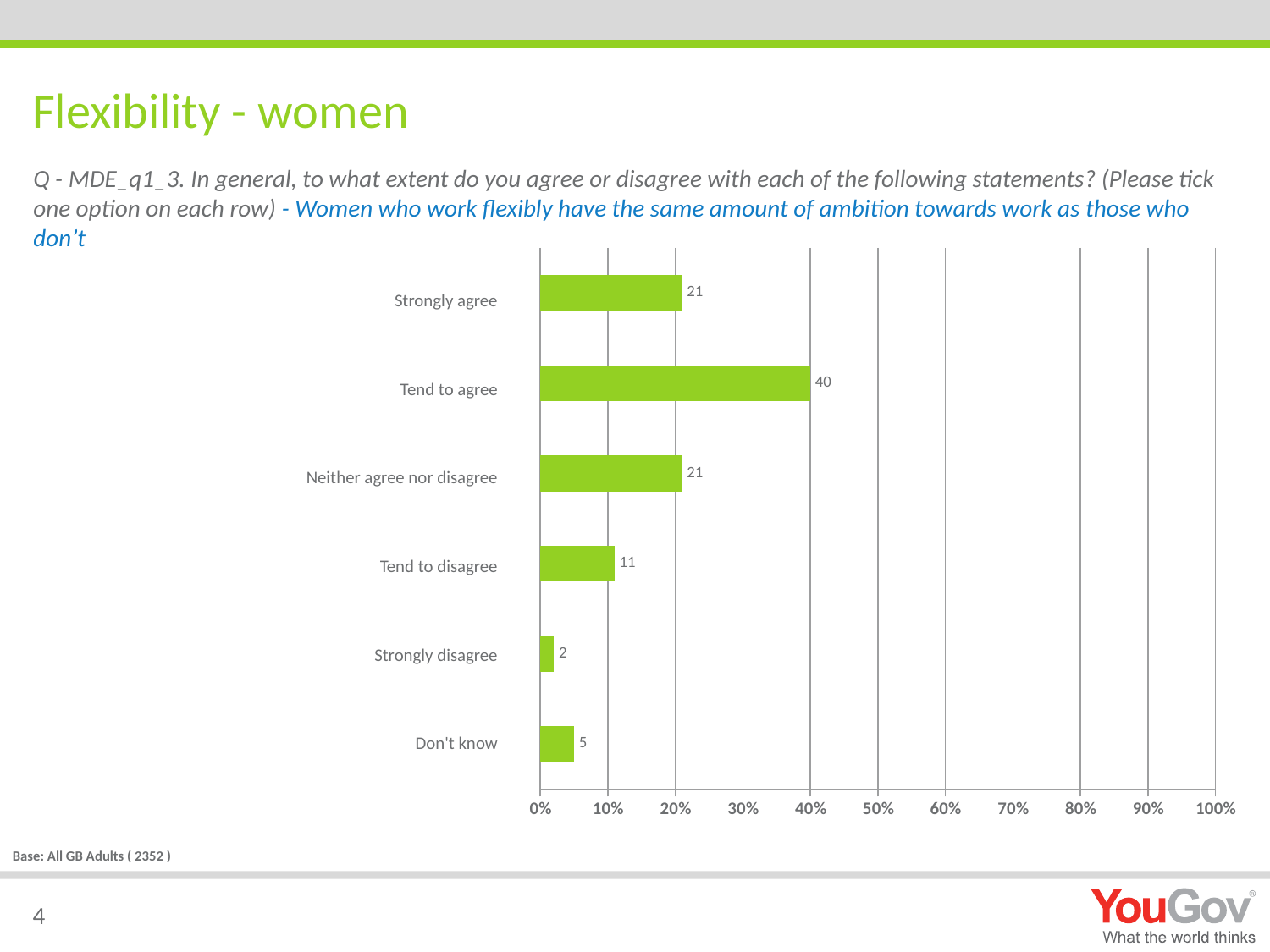
Is the value for "Tend to agree" greater or less than 30%? greater What is the difference between the values for "Tend to agree" and "Strongly agree"? 19 Which category has the highest value? Tend to agree What is the value for "Don't know"? 5 What is the title of the slide? Flexibility - women Which category has the lowest value? Strongly disagree What is the value for "Strongly disagree"? 2 What is the value for "Tend to agree"? 40 Which is larger, the value for "Tend to disagree" or the value for "Don't know"? Tend to disagree How many categories are shown in the chart? 6 What is the difference between the values for "Tend to disagree" and "Don't know"? 6 What kind of chart is shown on the slide? Bar chart